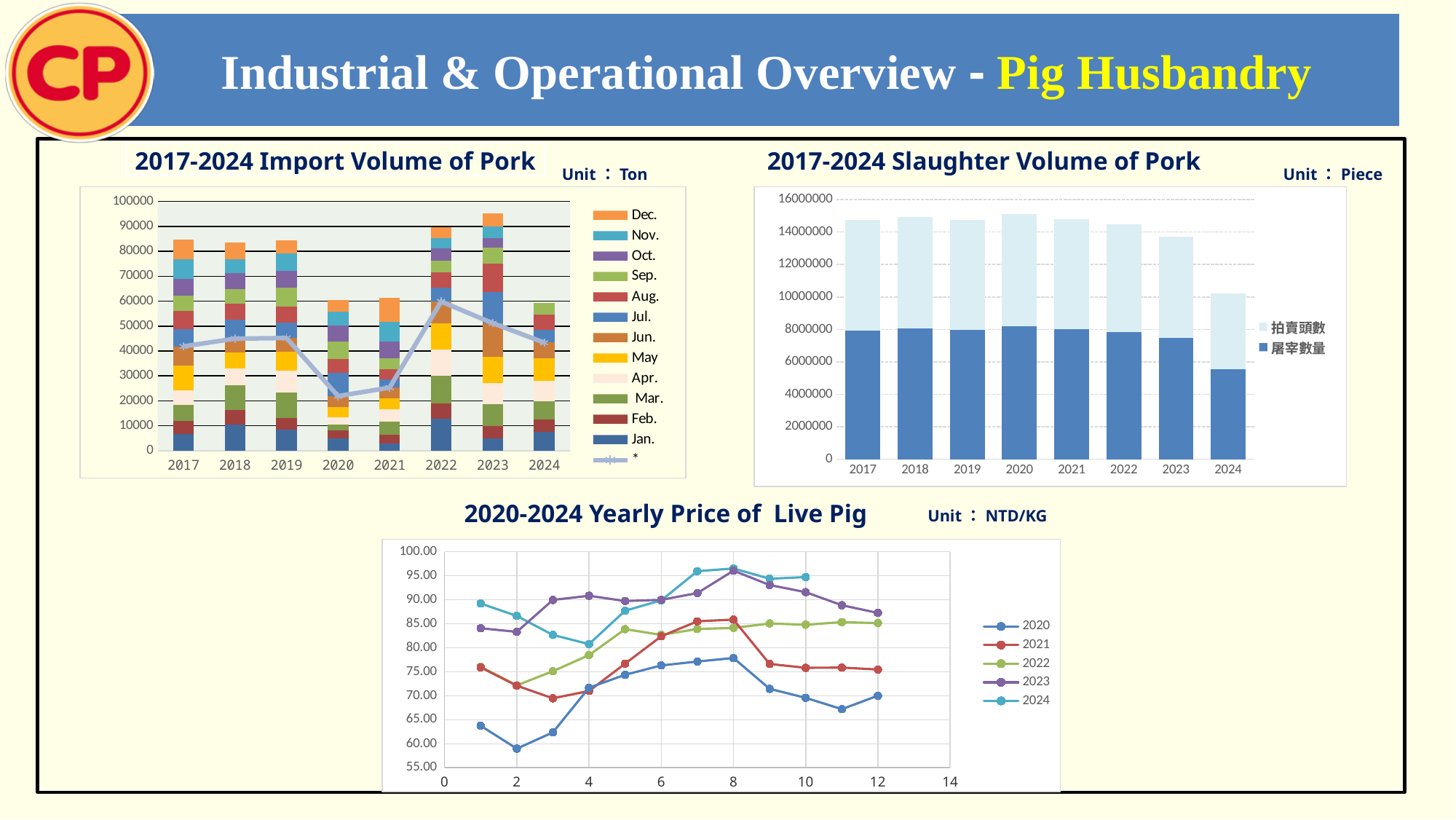
How many series does the legend of the '2017-2024 Slaughter Volume of Pork' chart list? 2 In the '2020-2024 Yearly Price of Live Pig' chart, which series is higher at month 1, 2020 or 2023? 2023 In the '2017-2024 Slaughter Volume of Pork' chart, which year has the lowest total? 2024 In the '2017-2024 Slaughter Volume of Pork' chart, is the total for 2024 greater or less than 12000000? less In the '2020-2024 Yearly Price of Live Pig' chart, is the 2020 value at month 2 greater or less than 60.00? less In the '2017-2024 Import Volume of Pork' chart, is the total for 2020 greater or less than 70000? less What kind of chart is the '2017-2024 Slaughter Volume of Pork' chart? bar chart In the '2017-2024 Import Volume of Pork' chart, how many years are shown on the x axis? 8 In the '2017-2024 Import Volume of Pork' chart, which year has the highest total import volume? 2023 What kind of chart is the '2020-2024 Yearly Price of Live Pig' chart? line chart How many series does the legend of the '2020-2024 Yearly Price of Live Pig' chart list? 5